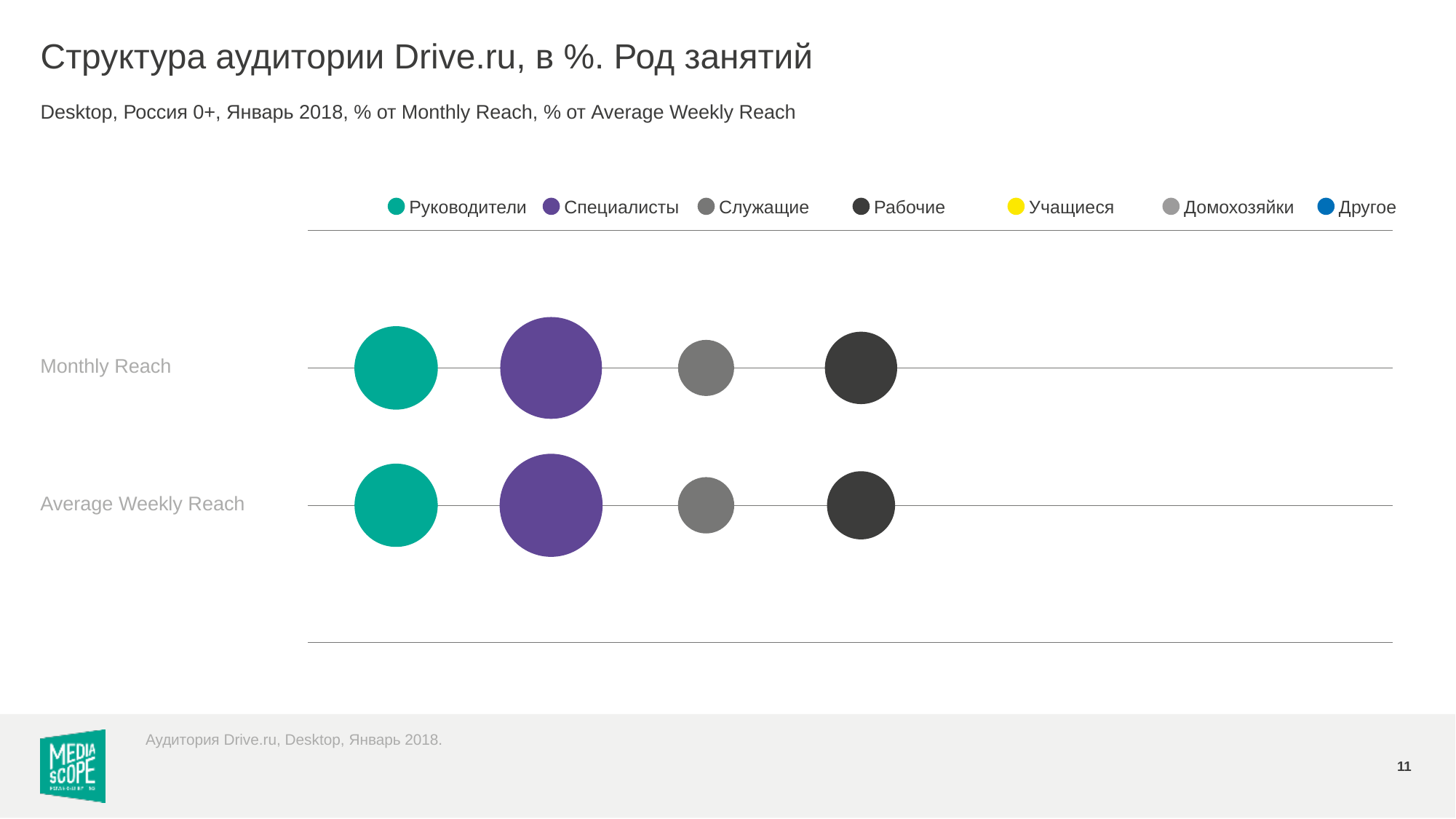
How many occupation groups have visible bubbles in the Monthly Reach row? 4 What kind of chart is shown on the slide? Bubble chart In the Monthly Reach row, which bubble is larger: Специалисты or Служащие? Специалисты In the Average Weekly Reach row, which bubble is larger: Руководители or Служащие? Руководители Which occupation group has the largest bubble in the Average Weekly Reach row? Специалисты What are the two row labels on the chart? Monthly Reach, Average Weekly Reach What is the title of the chart on the slide? Структура аудитории Drive.ru, в %. Род занятий How many rows (categories) are plotted on the chart? 2 Among the visible bubbles in the Monthly Reach row, which occupation group has the smallest bubble? Служащие How many series does the legend list? 7 Which occupation group has the largest bubble in the Monthly Reach row? Специалисты